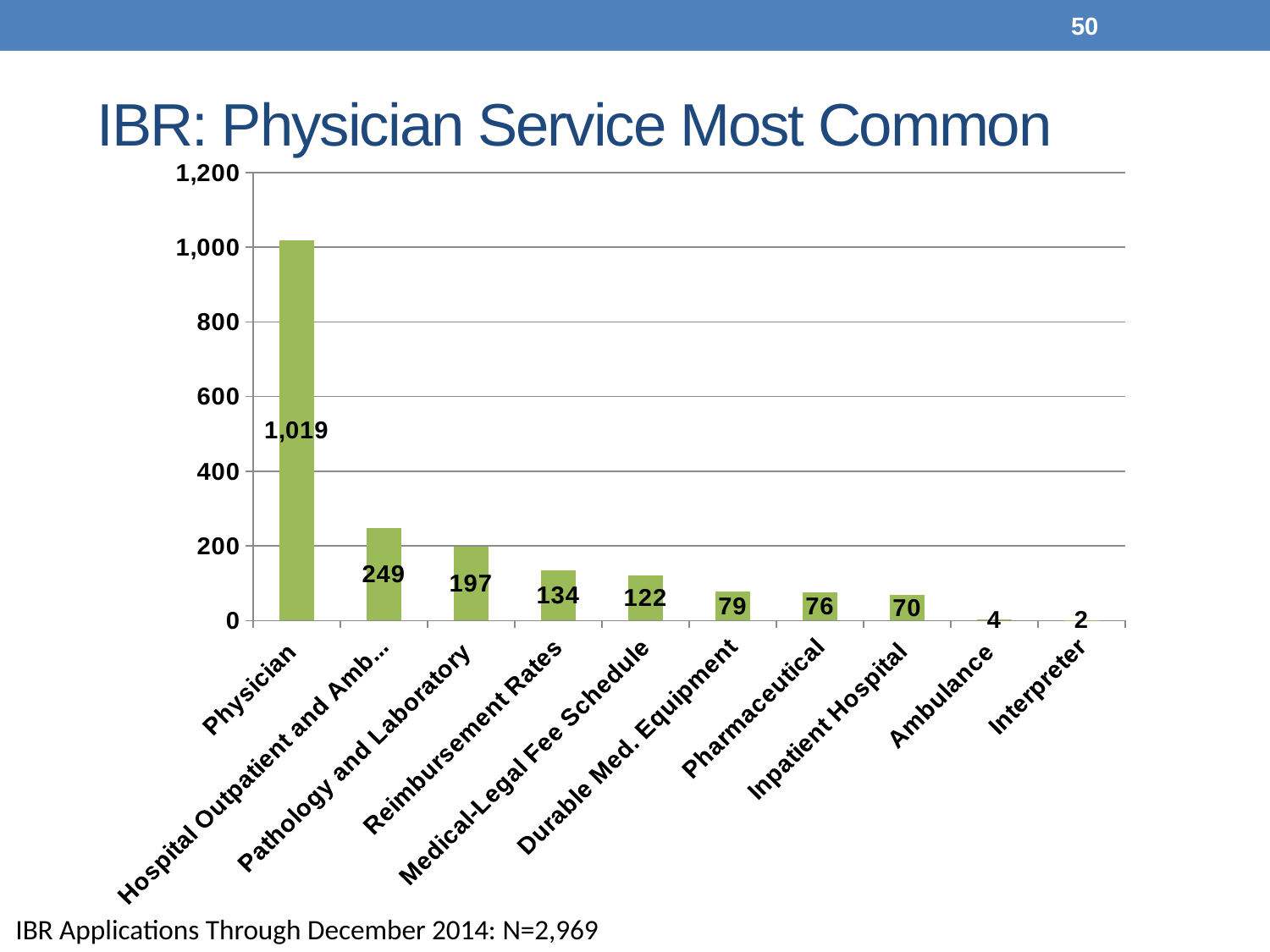
What is the difference between the values for Reimbursement Rates and Medical-Legal Fee Schedule? 12 What is the value for Physician? 1,019 Which is larger, the value for Durable Med. Equipment or the value for Inpatient Hospital? Durable Med. Equipment Do the values rise or fall from left to right along the x axis? Fall Is the value for Physician greater or less than 1,000? greater What is the value for Pathology and Laboratory? 197 Which category has the lowest value? Interpreter What is the value for Pharmaceutical? 76 What kind of chart is shown on the slide? Bar chart What is the value for Interpreter? 2 How many categories are shown on the x axis? 10 Which category has the highest value? Physician